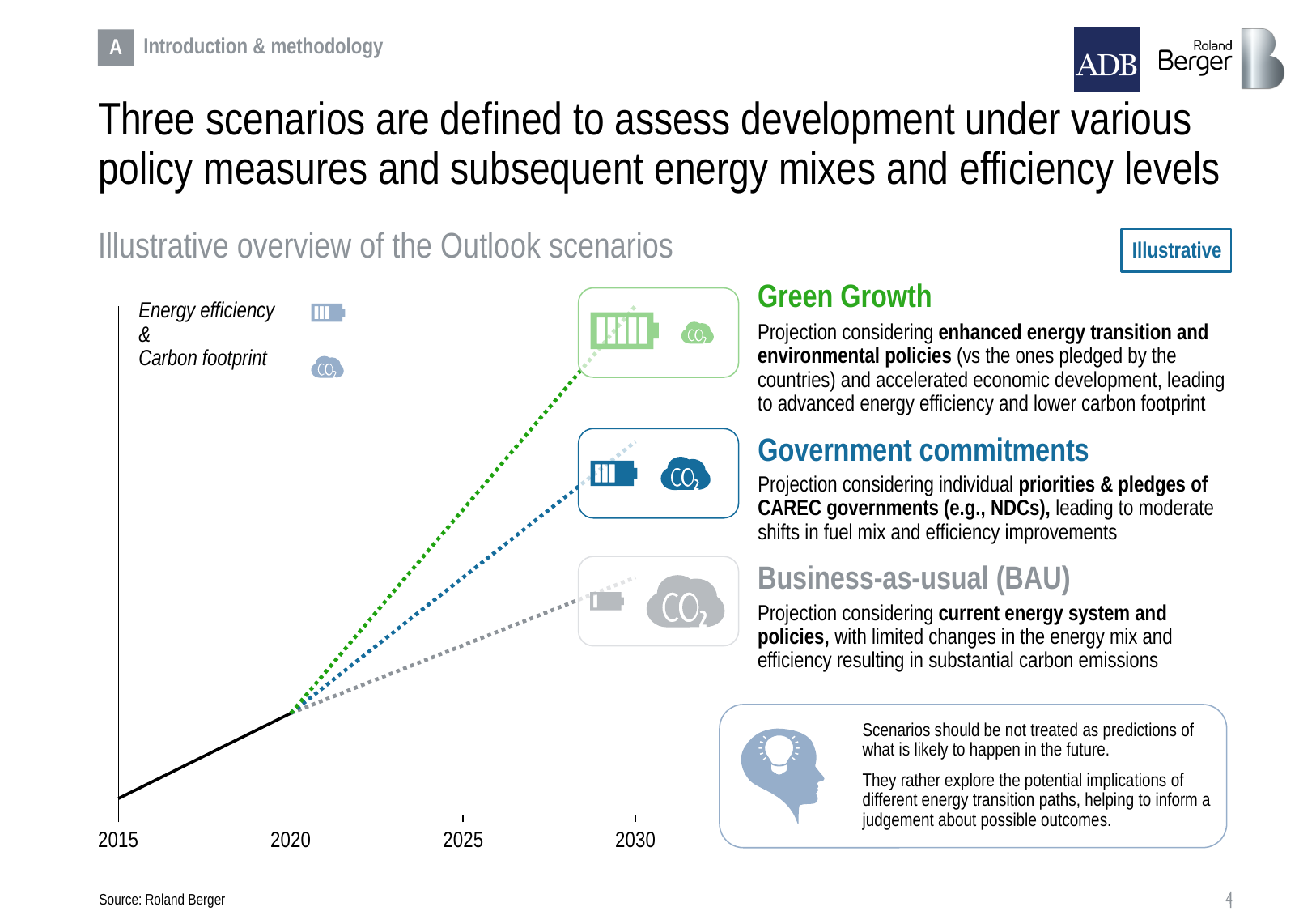
Which scenario line reaches the lowest point by 2030? Business-as-usual (BAU) How many scenario lines branch off from 2020 in the chart? 3 In which year do the three scenario lines diverge from the single black line? 2020 Which scenario line reaches the highest point by 2030? Green Growth Do the scenario lines rise or fall from 2020 to 2030? rise What is the last year shown on the x axis? 2030 Which line is higher in 2030, Government commitments or Business-as-usual (BAU)? Government commitments What kind of chart is shown on the slide? line chart What is the title of the chart? Illustrative overview of the Outlook scenarios Which line is higher in 2030, Green Growth or Government commitments? Green Growth What is the first year shown on the x axis? 2015 What colour is the Green Growth scenario line? green